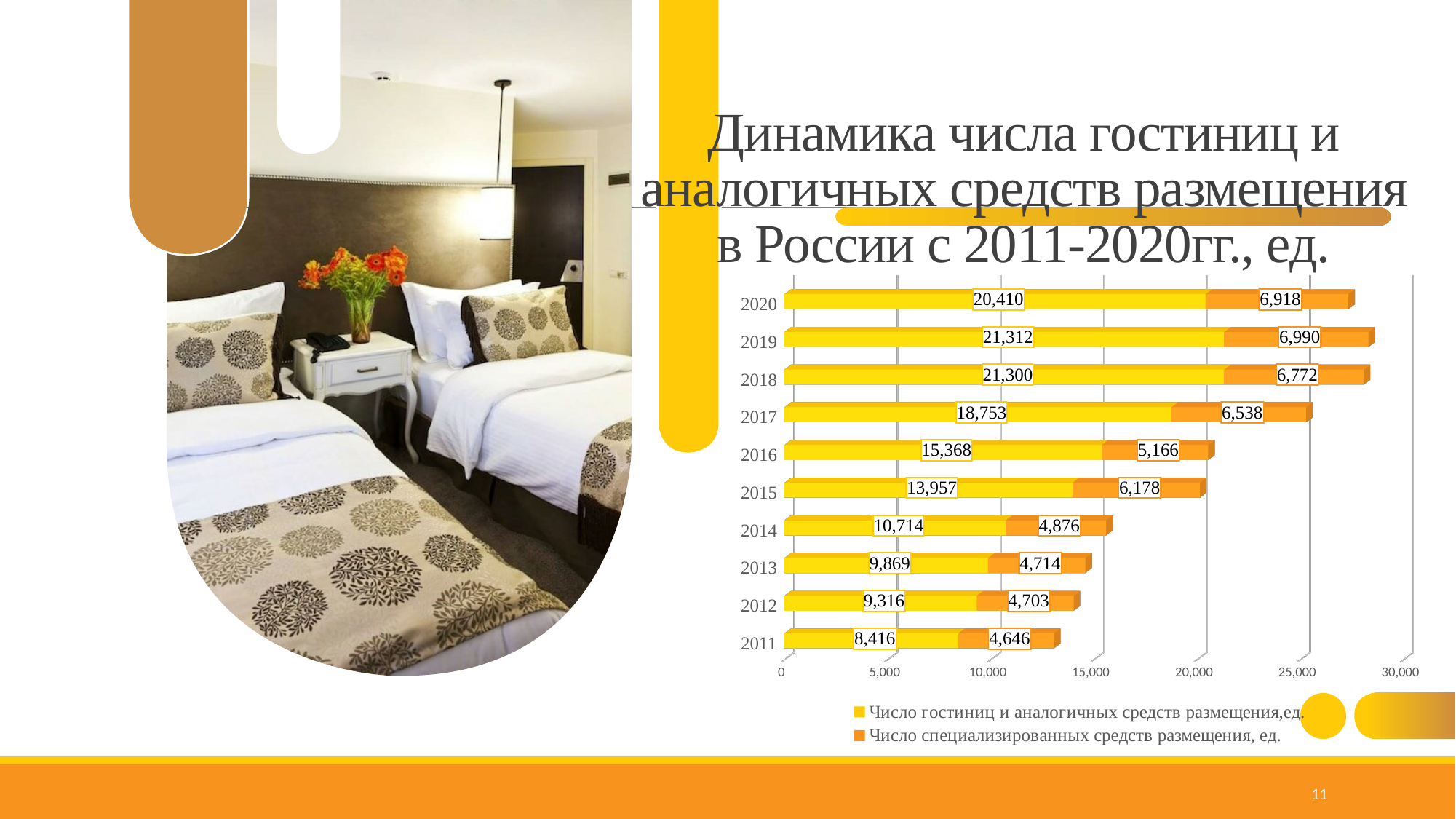
Which year has the larger number of specialized accommodation facilities, 2015 or 2016? 2015 In which year is the number of specialized accommodation facilities the lowest? 2011 What is the number of hotels and similar accommodation facilities (Число гостиниц и аналогичных средств размещения) in 2020? 20,410 How many years are shown on the chart? 10 What is the total of the stacked bar for 2011 (both series combined)? 13,062 What is the number of hotels and similar accommodation facilities in 2014? 10,714 How many series does the legend list? 2 What kind of chart is shown on the slide? Stacked bar chart What is the total of the stacked bar for 2020 (both series combined)? 27,328 What is the number of specialized accommodation facilities (Число специализированных средств размещения) in 2015? 6,178 What is the difference between the number of hotels and similar accommodation facilities in 2018 and in 2017? 2,547 In which year is the number of hotels and similar accommodation facilities the lowest? 2011